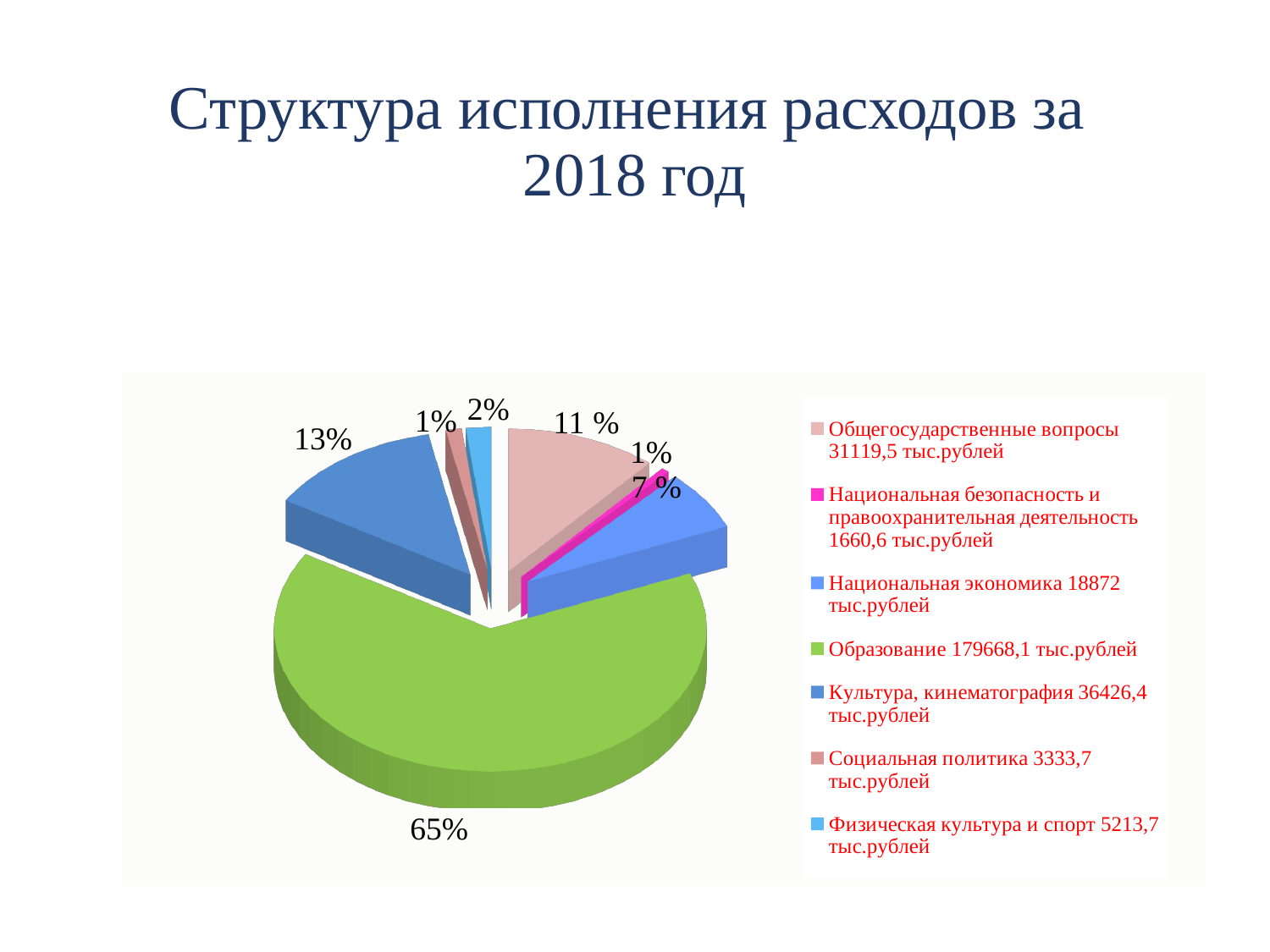
How many categories does the pie chart show? 7 Which category has the largest share of the pie? Образование What share of the pie does Образование represent? 65% What share of the pie does Культура, кинематография represent? 13% According to the legend, what is the value for Образование? 179668,1 тыс.рублей What is the title of the slide containing the chart? Структура исполнения расходов за 2018 год Which category has the smallest value according to the legend? Национальная безопасность и правоохранительная деятельность What share of the pie does Национальная экономика represent? 7 % Which is larger: the value for Культура, кинематография or the value for Общегосударственные вопросы? Культура, кинематография According to the legend, what is the value for Физическая культура и спорт? 5213,7 тыс.рублей What type of chart is shown on the slide? Pie chart